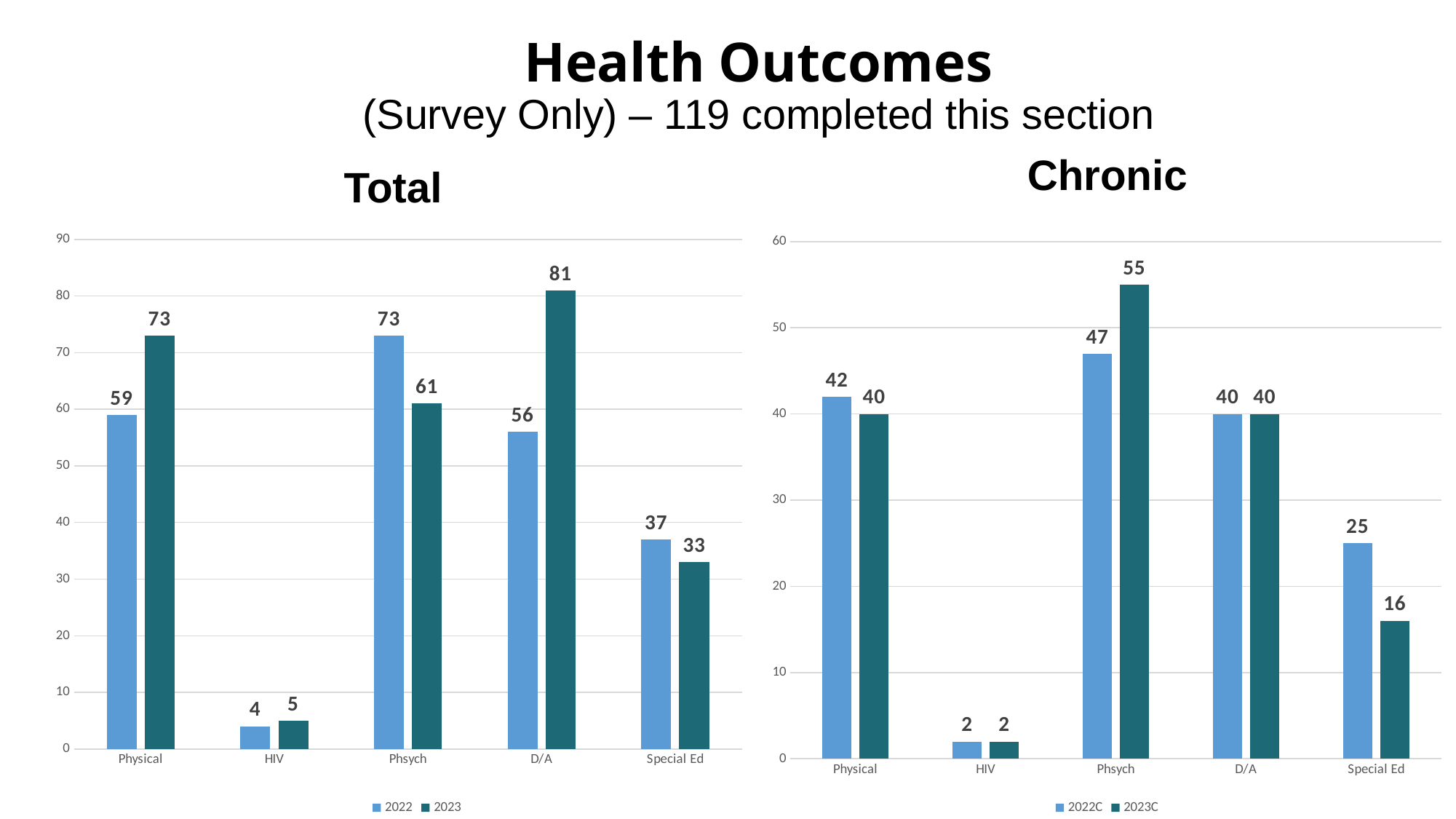
In the Chronic chart, which category has the highest 2023C value? Phsych In the Total chart, what is the 2022 value for Special Ed? 37 How many series does the legend of the Total chart list? 2 In the Chronic chart, what is the difference between the 2022C and 2023C values for Special Ed? 9 What type of chart is the Chronic chart? Bar chart In the Total chart, what is the difference between the 2023 and 2022 values for D/A? 25 How many categories are shown on the x axis of the Chronic chart? 5 In the Chronic chart, what is the 2022C value for Physical? 42 In the Total chart, what is the 2023 value for D/A? 81 In the Total chart, which is larger for Phsych: the 2022 value or the 2023 value? 2022 In the Total chart, which category has the lowest 2022 value? HIV In the Chronic chart, what is the 2023C value for Phsych? 55